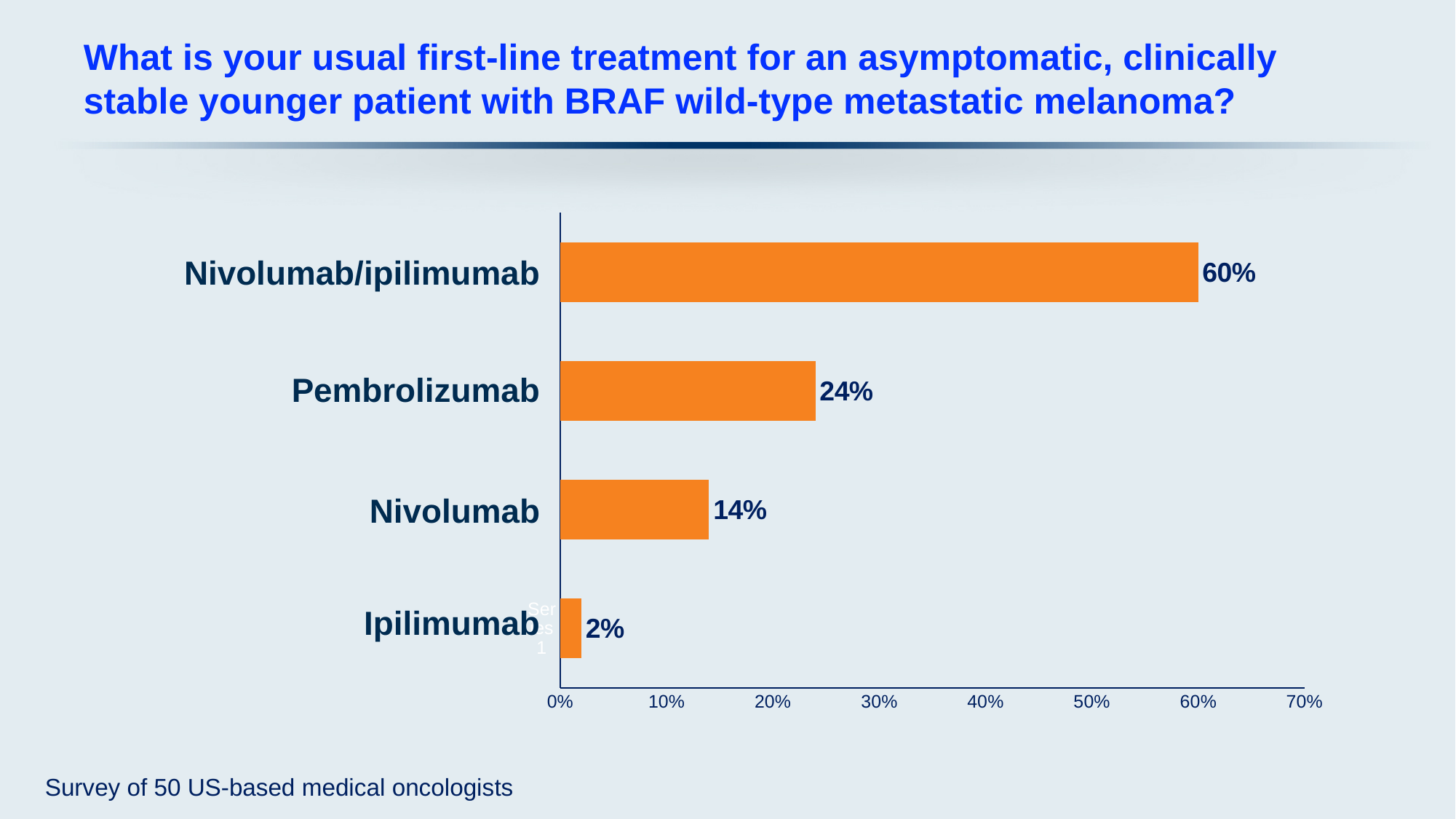
How many treatment options are shown in the chart? 4 What is the difference in percentage points between Nivolumab/ipilimumab and Pembrolizumab? 36% What percentage of respondents chose Nivolumab/ipilimumab as their usual first-line treatment? 60% Which treatment has the highest percentage? Nivolumab/ipilimumab What is the value shown for Pembrolizumab? 24% What type of chart is shown on the slide? Bar chart What is the difference between the values for Pembrolizumab and Nivolumab? 10% What is the value shown for Ipilimumab? 2% Which treatment has the lowest percentage? Ipilimumab Which has a larger value, Nivolumab or Ipilimumab? Nivolumab What is the value shown for Nivolumab? 14% What is the maximum value shown on the horizontal axis? 70%